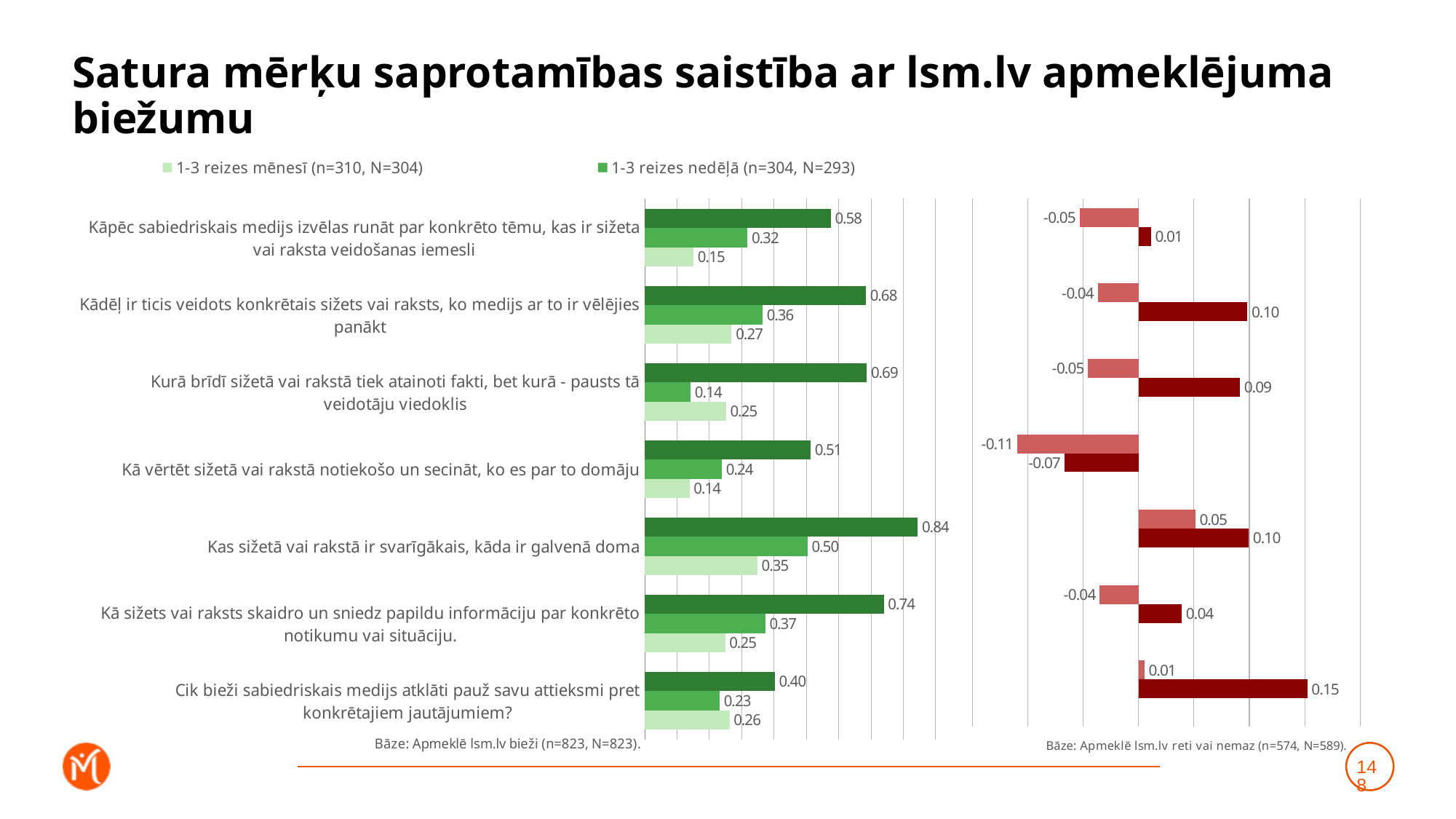
How many series does the legend at the top of the slide list? 2 On the left chart, what is the value for '1-3 reizes mēnesī' in the category 'Kādēļ ir ticis veidots konkrētais sižets vai raksts, ko medijs ar to ir vēlējies panākt'? 0.27 What kind of chart is the left chart? Bar chart On the left chart, which category has the lowest value for '1-3 reizes nedēļā'? Kurā brīdī sižetā vai rakstā tiek atainoti fakti, bet kurā - pausts tā veidotāju viedoklis How many categories are shown on the left chart? 7 On the left chart, what is the value for '1-3 reizes nedēļā' in the category 'Kas sižetā vai rakstā ir svarīgākais, kāda ir galvenā doma'? 0.50 On the left chart, which category has the highest value for '1-3 reizes nedēļā'? Kas sižetā vai rakstā ir svarīgākais, kāda ir galvenā doma On the left chart, what is the difference between the '1-3 reizes nedēļā' and '1-3 reizes mēnesī' values for 'Kāpēc sabiedriskais medijs izvēlas runāt par konkrēto tēmu, kas ir sižeta vai raksta veidošanas iemesli'? 0.17 On the right chart, what is the lowest value printed on any bar? -0.11 On the left chart, what is the highest value printed on any bar? 0.84 On the right chart, what is the highest value printed on any bar? 0.15 On the left chart, for 'Cik bieži sabiedriskais medijs atklāti pauž savu attieksmi pret konkrētajiem jautājumiem?', which is larger: '1-3 reizes nedēļā' or '1-3 reizes mēnesī'? 1-3 reizes mēnesī